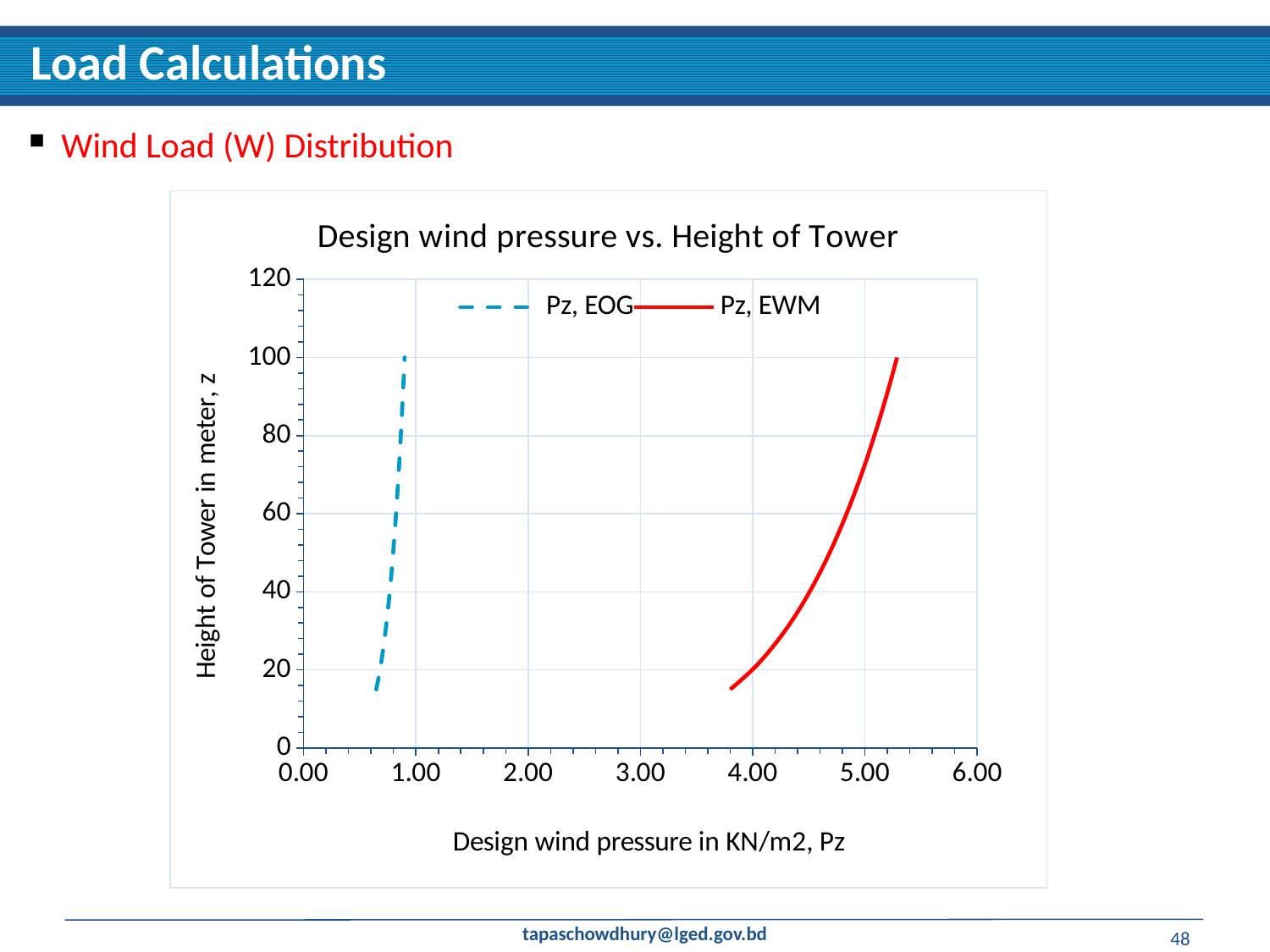
Which series is drawn with a dashed line? Pz, EOG What is the label of the x axis? Design wind pressure in KN/m2, Pz Is the Pz, EWM value at a tower height of 40 m greater or less than 3.00? greater What kind of chart is shown on the slide? line chart Is the Pz, EWM value at its lowest plotted height greater or less than 4.00? less As the height of the tower increases, does the Pz, EWM design wind pressure rise or fall? rise How many series does the legend list? 2 What is the maximum value shown on the y axis? 120 Which series has the higher design wind pressure at a tower height of 60 m, Pz, EOG or Pz, EWM? Pz, EWM Is the Pz, EWM value at a tower height of 100 m greater or less than 5.00? greater